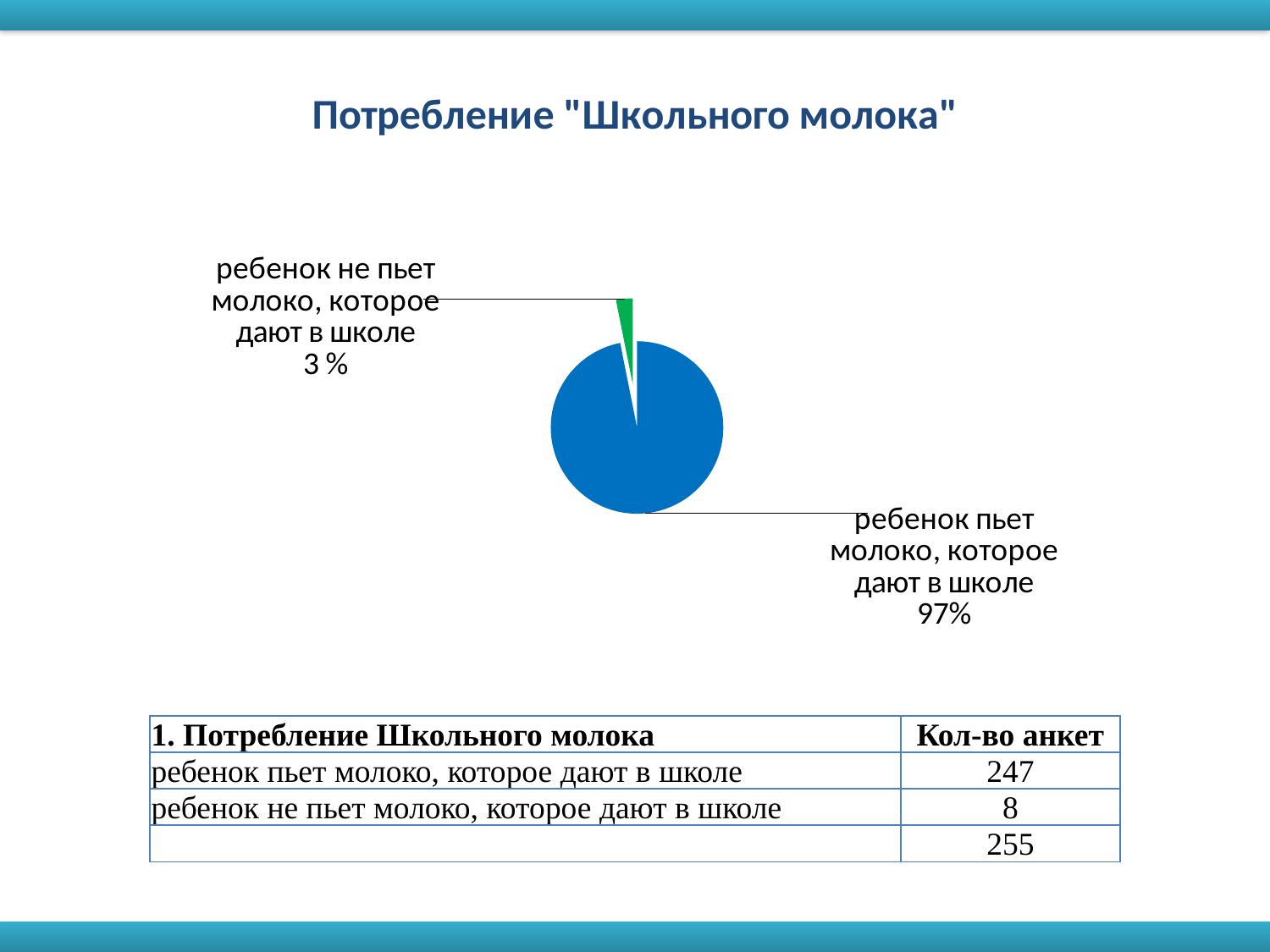
How many slices does the pie chart have? 2 Which slice of the pie chart is the smallest? ребенок не пьет молоко, которое дают в школе Which slice of the pie chart is the largest? ребенок пьет молоко, которое дают в школе What kind of chart is shown on the slide? pie chart What is the title of the chart on the slide? Потребление "Школьного молока" By how many percentage points does the "ребенок пьет молоко" slice exceed the "ребенок не пьет молоко" slice? 94 What share of the pie is labelled "ребенок пьет молоко, которое дают в школе"? 97% What share of the pie is labelled "ребенок не пьет молоко, которое дают в школе"? 3 % Is the share for "ребенок пьет молоко, которое дают в школе" greater or less than 50%? greater Which is larger: the share for "ребенок пьет молоко, которое дают в школе" or the share for "ребенок не пьет молоко, которое дают в школе"? ребенок пьет молоко, которое дают в школе What colour is the slice for "ребенок не пьет молоко, которое дают в школе"? green